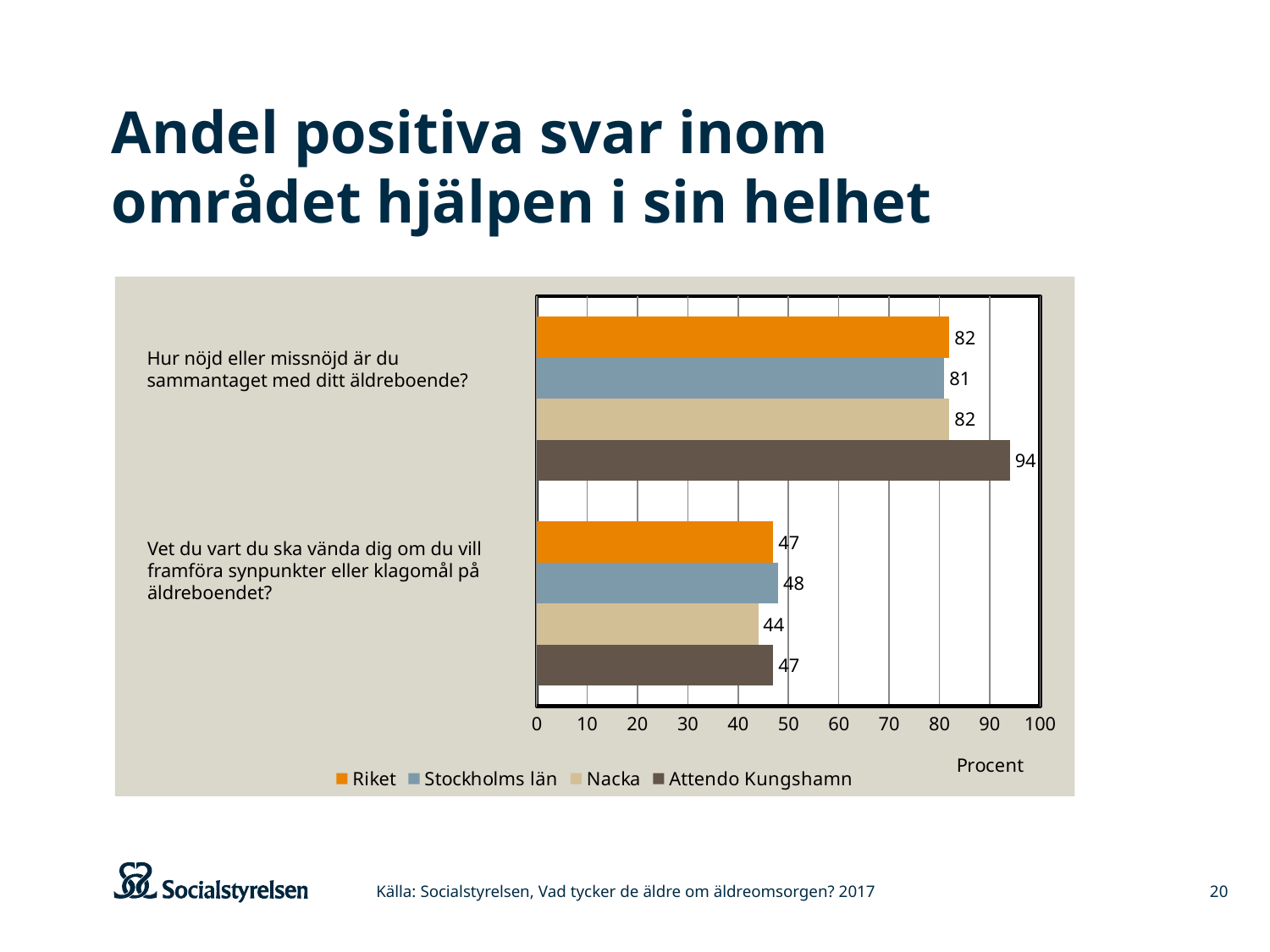
Which series has the highest value for the question "Hur nöjd eller missnöjd är du sammantaget med ditt äldreboende?"? Attendo Kungshamn Which series has the lowest value for the question "Vet du vart du ska vända dig om du vill framföra synpunkter eller klagomål på äldreboendet?"? Nacka What is the value for Nacka for the question "Vet du vart du ska vända dig om du vill framföra synpunkter eller klagomål på äldreboendet?"? 44 What is the difference between the Attendo Kungshamn value and the Riket value for the question "Hur nöjd eller missnöjd är du sammantaget med ditt äldreboende?"? 12 Is the value for Attendo Kungshamn for the question "Hur nöjd eller missnöjd är du sammantaget med ditt äldreboende?" greater or less than 90? greater How many series does the legend list? 4 What kind of chart is shown on the slide? Bar chart For the question "Vet du vart du ska vända dig om du vill framföra synpunkter eller klagomål på äldreboendet?", which is larger: the value for Stockholms län or the value for Nacka? Stockholms län What is the value for Stockholms län for the question "Hur nöjd eller missnöjd är du sammantaget med ditt äldreboende?"? 81 What is the value for Riket for the question "Vet du vart du ska vända dig om du vill framföra synpunkter eller klagomål på äldreboendet?"? 47 What unit label is shown on the x axis of the chart? Procent What is the value for Attendo Kungshamn for the question "Hur nöjd eller missnöjd är du sammantaget med ditt äldreboende?"? 94